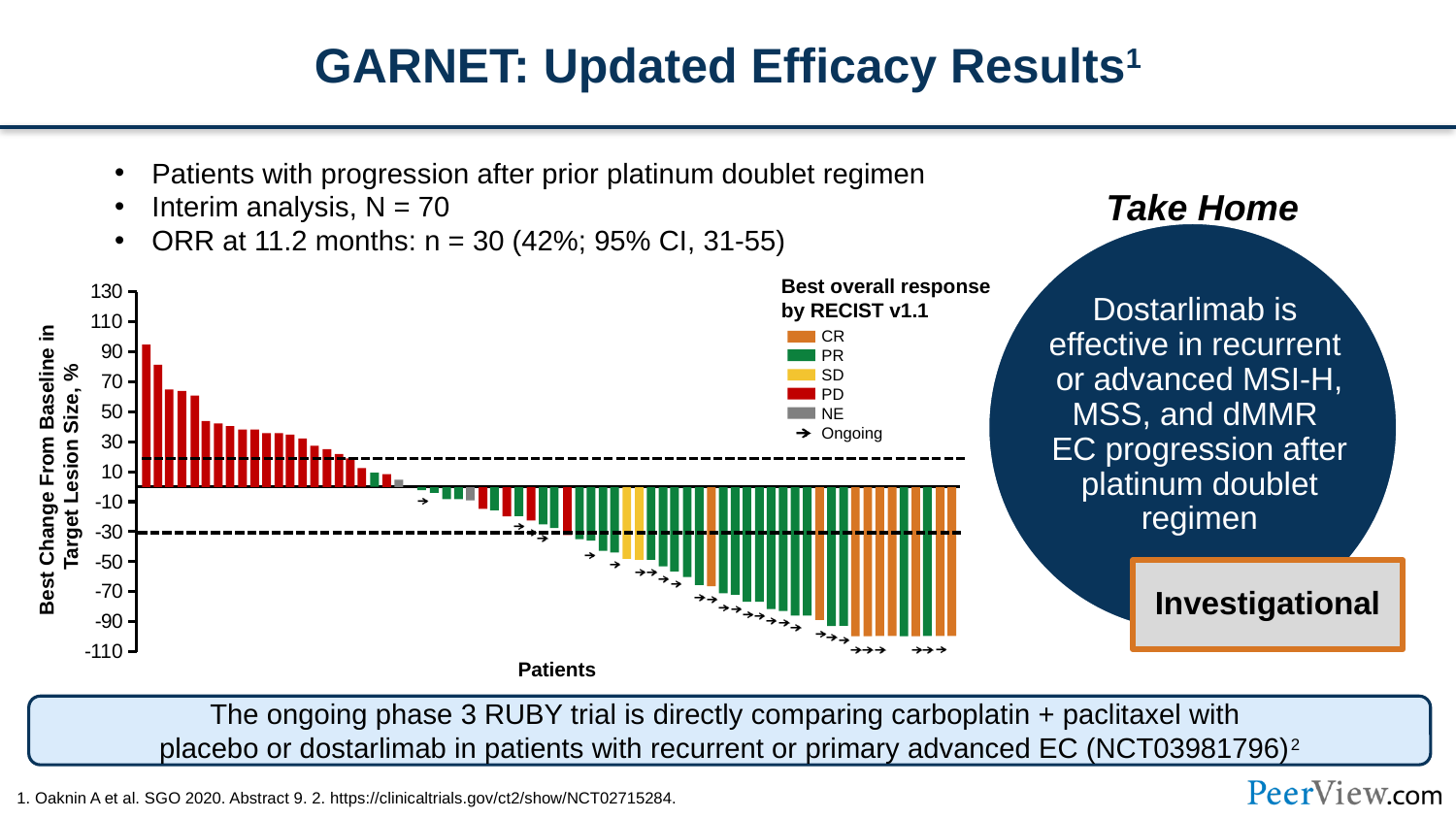
Which response category does the tallest positive bar belong to? PD What kind of chart is shown on the slide? Bar chart Do the bar values rise or fall moving from left to right along the x axis? Fall Is the value of the rightmost bar greater or less than -50? less Is the value of the tallest positive bar greater or less than 70? greater What is the title of the legend? Best overall response by RECIST v1.1 How many patients are included in the interim analysis shown? 70 Is the value of the leftmost bar greater or less than 50? greater How many response categories (excluding the Ongoing marker) does the legend list? 5 What is the title of the y axis? Best Change From Baseline in Target Lesion Size, % Which response category do the lowest bars on the right belong to? CR